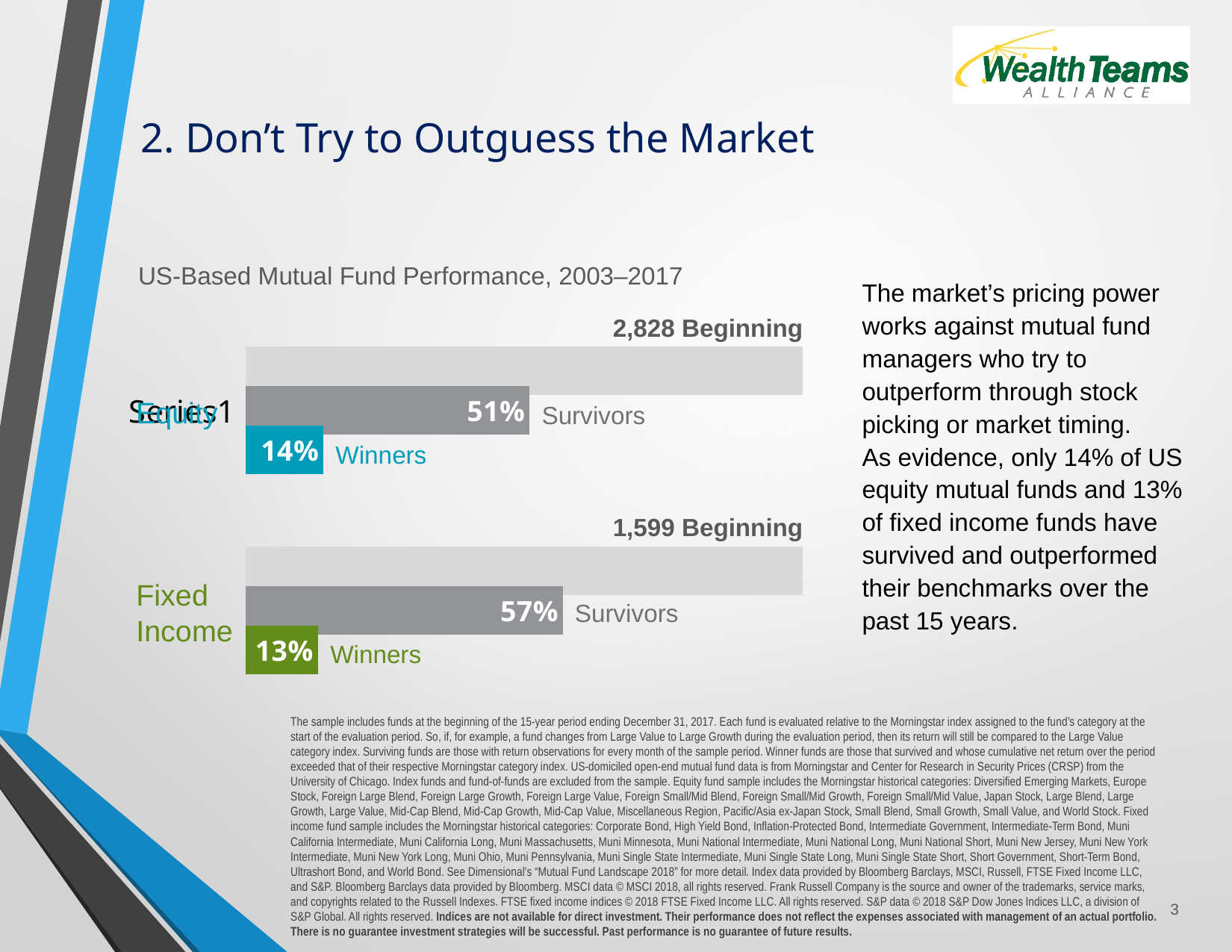
What is the title of the chart? US-Based Mutual Fund Performance, 2003–2017 What is the difference between the Survivors and Winners percentages for Equity? 37% What is the difference between the Survivors percentage for Fixed Income and for Equity? 6% Which category had the higher Winners percentage, Equity or Fixed Income? Equity What percentage of fixed income funds were Survivors? 57% What percentage of fixed income funds were Winners? 13% What percentage of US equity mutual funds were Survivors? 51% How many fixed income funds were there at the beginning of the period? 1,599 How many equity funds were there at the beginning of the period? 2,828 What type of chart is shown on the slide? Bar chart What percentage of US equity mutual funds were Winners? 14% Which category had the higher Survivors percentage, Equity or Fixed Income? Fixed Income